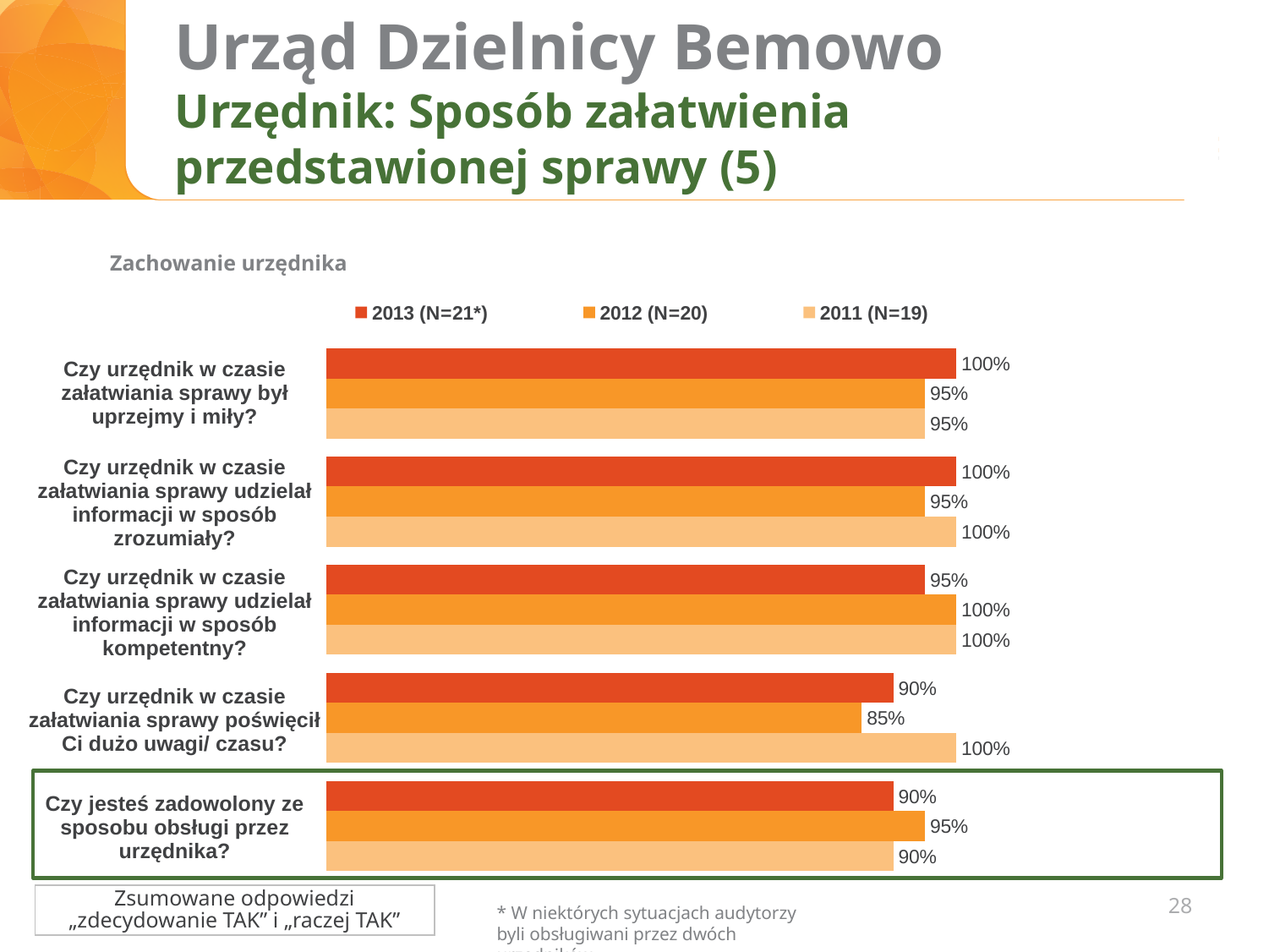
Which category has the lowest 2013 (N=21*) value? Czy urzędnik w czasie załatwiania sprawy poświęcił Ci dużo uwagi/ czasu? and Czy jesteś zadowolony ze sposobu obsługi przez urzędnika? (both 90%) What is the title shown above the chart? Zachowanie urzędnika What is the 2013 (N=21*) value for "Czy urzędnik w czasie załatwiania sprawy udzielał informacji w sposób kompetentny?"? 95% What is the difference between the 2011 (N=19) and 2012 (N=20) values for "Czy urzędnik w czasie załatwiania sprawy poświęcił Ci dużo uwagi/ czasu?"? 15% What is the 2012 (N=20) value for "Czy urzędnik w czasie załatwiania sprawy poświęcił Ci dużo uwagi/ czasu?"? 85% What is the 2011 (N=19) value for "Czy jesteś zadowolony ze sposobu obsługi przez urzędnika?"? 90% For "Czy jesteś zadowolony ze sposobu obsługi przez urzędnika?", which is larger: the 2012 (N=20) value or the 2013 (N=21*) value? 2012 (N=20) How many series does the legend list? 3 Which year has the lowest value for "Czy urzędnik w czasie załatwiania sprawy poświęcił Ci dużo uwagi/ czasu?"? 2012 (N=20) How many question categories are shown on the chart? 5 What type of chart is shown on the slide? bar chart What is the 2013 (N=21*) value for "Czy urzędnik w czasie załatwiania sprawy był uprzejmy i miły?"? 100%